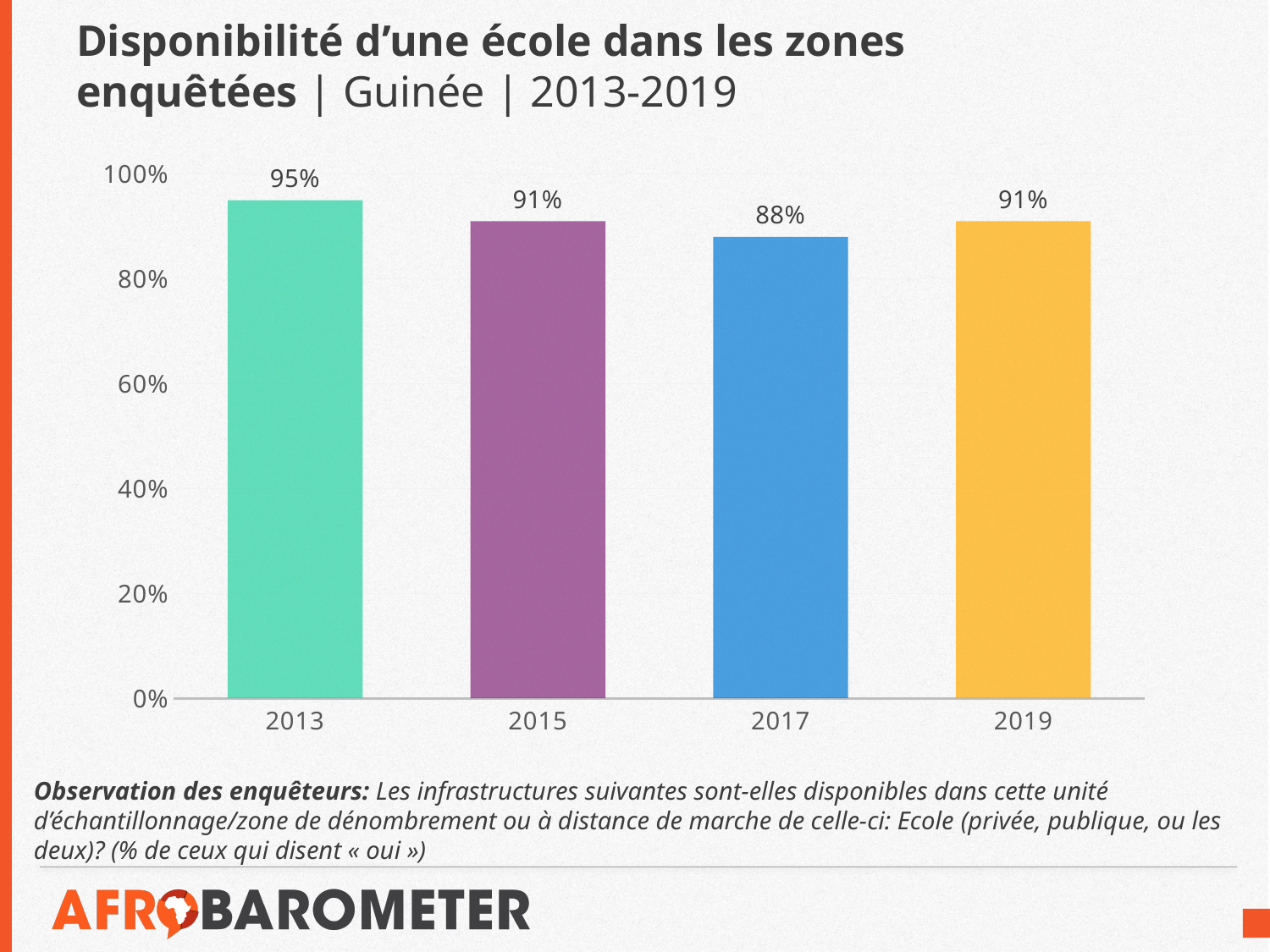
Which is larger, the value for 2013 or the value for 2015? 2013 How many years are shown on the x axis? 4 Is the value for 2017 greater or less than 80%? greater What is the value for 2019? 91% What is the value for 2013? 95% Which year has the lowest value? 2017 Which year has the highest value? 2013 What kind of chart is shown on the slide? Bar chart What is the value for 2017? 88% What colour is the bar for 2019? Yellow What is the difference between the values for 2013 and 2017? 7 percentage points Does the value rise or fall from 2013 to 2017? Fall